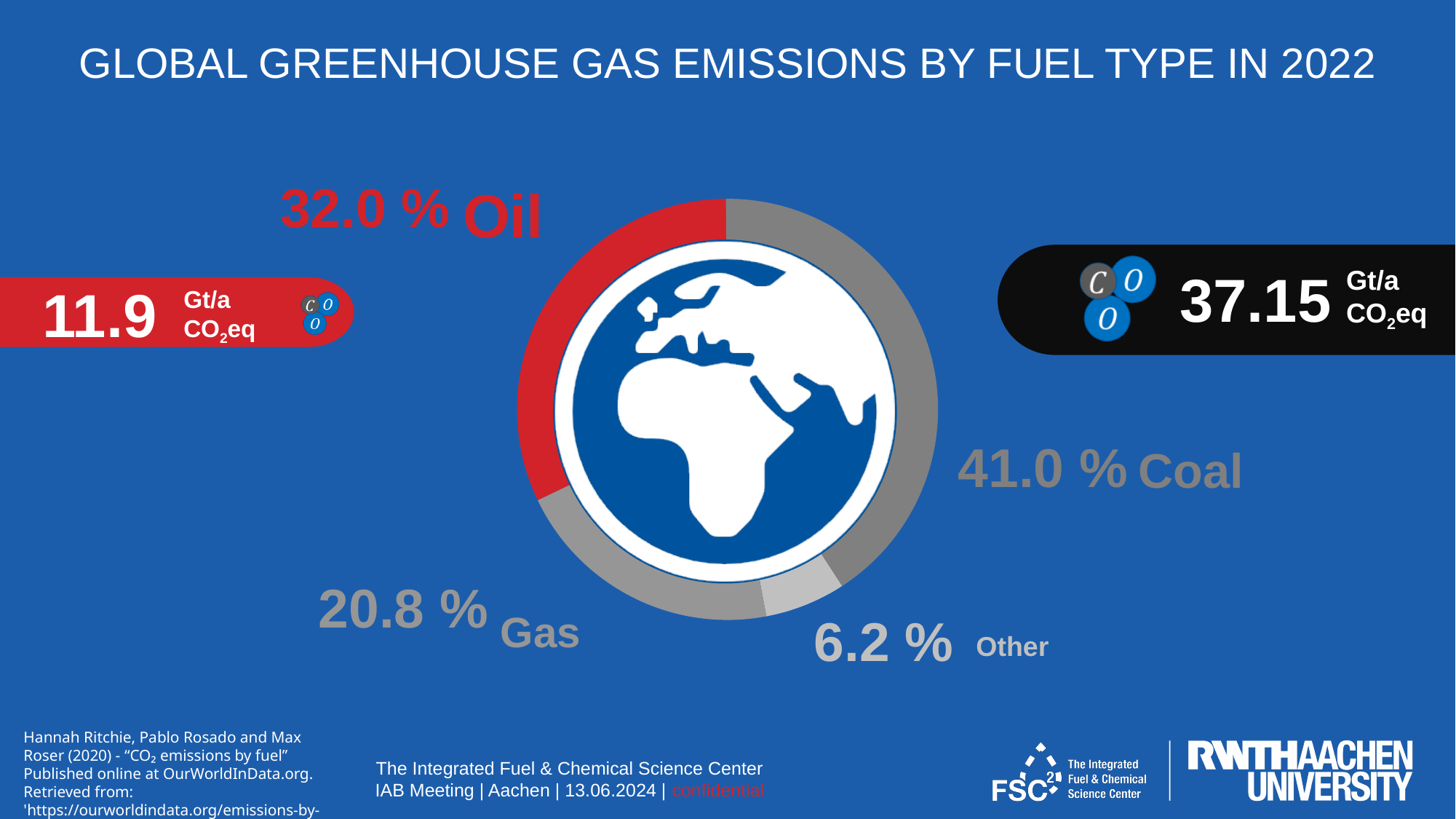
What percentage is shown for Other? 6.2 % What share of global greenhouse gas emissions by fuel type in 2022 does Coal account for? 41.0 % Which has a larger share, Gas or Oil? Oil How many fuel-type categories are shown in the chart? 4 What total annual emissions figure is shown in the black callout on the right? 37.15 Gt/a CO2eq What kind of chart is used to show the emissions by fuel type? Donut (pie) chart Which fuel type has the largest share of emissions in the chart? Coal What percentage is shown for Gas? 20.8 % Which fuel type has the smallest share of emissions in the chart? Other What colour is the Oil slice of the chart? Red How many percentage points larger is the Coal share than the Oil share? 9.0 % What share of the donut chart is labelled Oil? 32.0 %